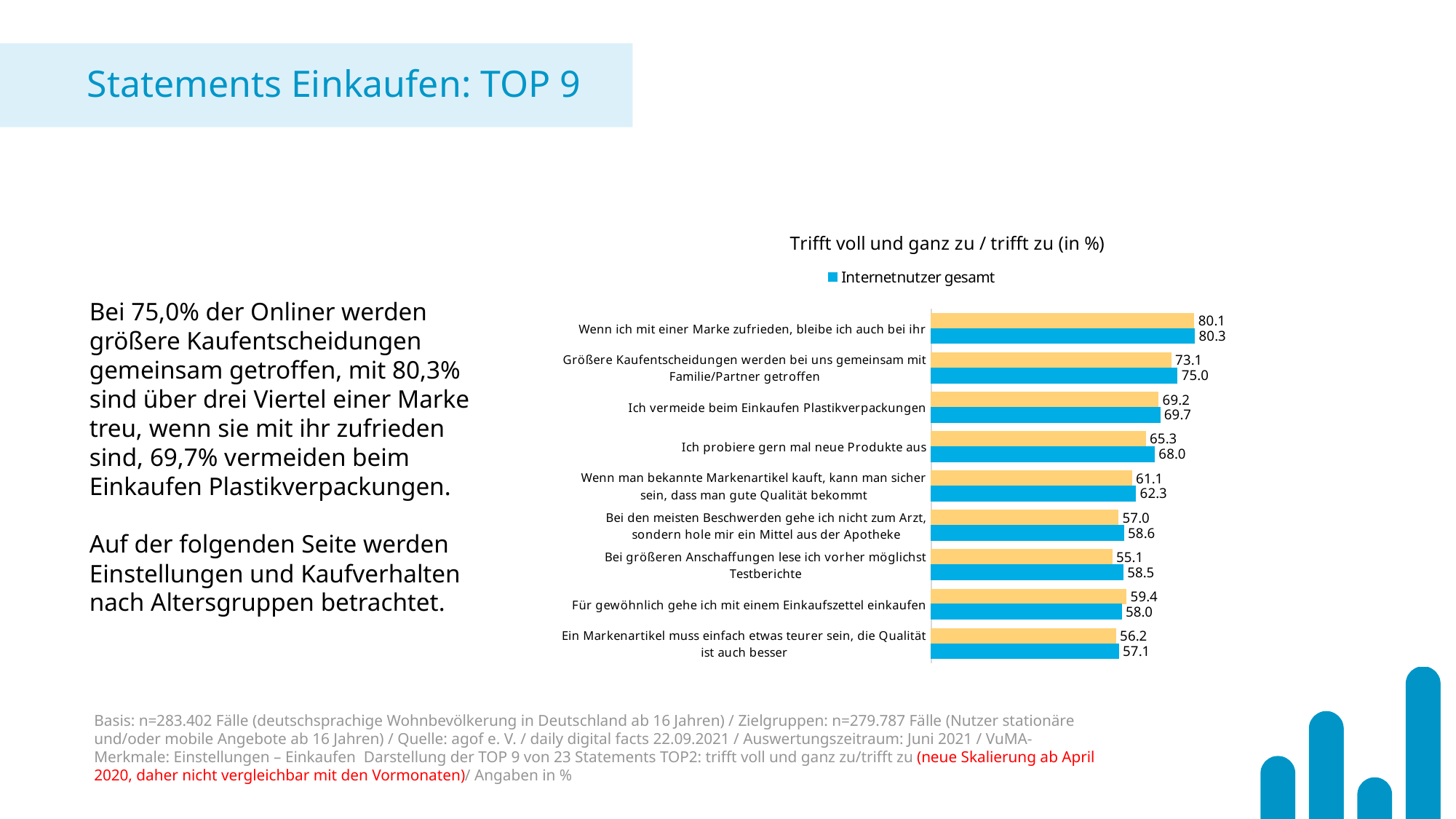
What is the Internetnutzer gesamt value for "Für gewöhnlich gehe ich mit einem Einkaufszettel einkaufen"? 58.0 Which has the larger Internetnutzer gesamt value: "Ich probiere gern mal neue Produkte aus" or "Wenn man bekannte Markenartikel kauft, kann man sicher sein, dass man gute Qualität bekommt"? Ich probiere gern mal neue Produkte aus How many series does the chart legend list? 1 What is the title of the chart? Trifft voll und ganz zu / trifft zu (in %) Which statement has the lowest Internetnutzer gesamt value? Ein Markenartikel muss einfach etwas teurer sein, die Qualität ist auch besser For "Bei größeren Anschaffungen lese ich vorher möglichst Testberichte", what is the difference between the blue bar value and the yellow bar value? 3.4 What is the Internetnutzer gesamt value for "Ich vermeide beim Einkaufen Plastikverpackungen"? 69.7 What kind of chart is shown on the slide? Bar chart What is the difference between the Internetnutzer gesamt values for "Wenn ich mit einer Marke zufrieden, bleibe ich auch bei ihr" and "Größere Kaufentscheidungen werden bei uns gemeinsam mit Familie/Partner getroffen"? 5.3 How many statements are shown in the chart? 9 Which statement has the highest Internetnutzer gesamt value? Wenn ich mit einer Marke zufrieden, bleibe ich auch bei ihr What value is shown on the yellow bar for "Ich probiere gern mal neue Produkte aus"? 65.3